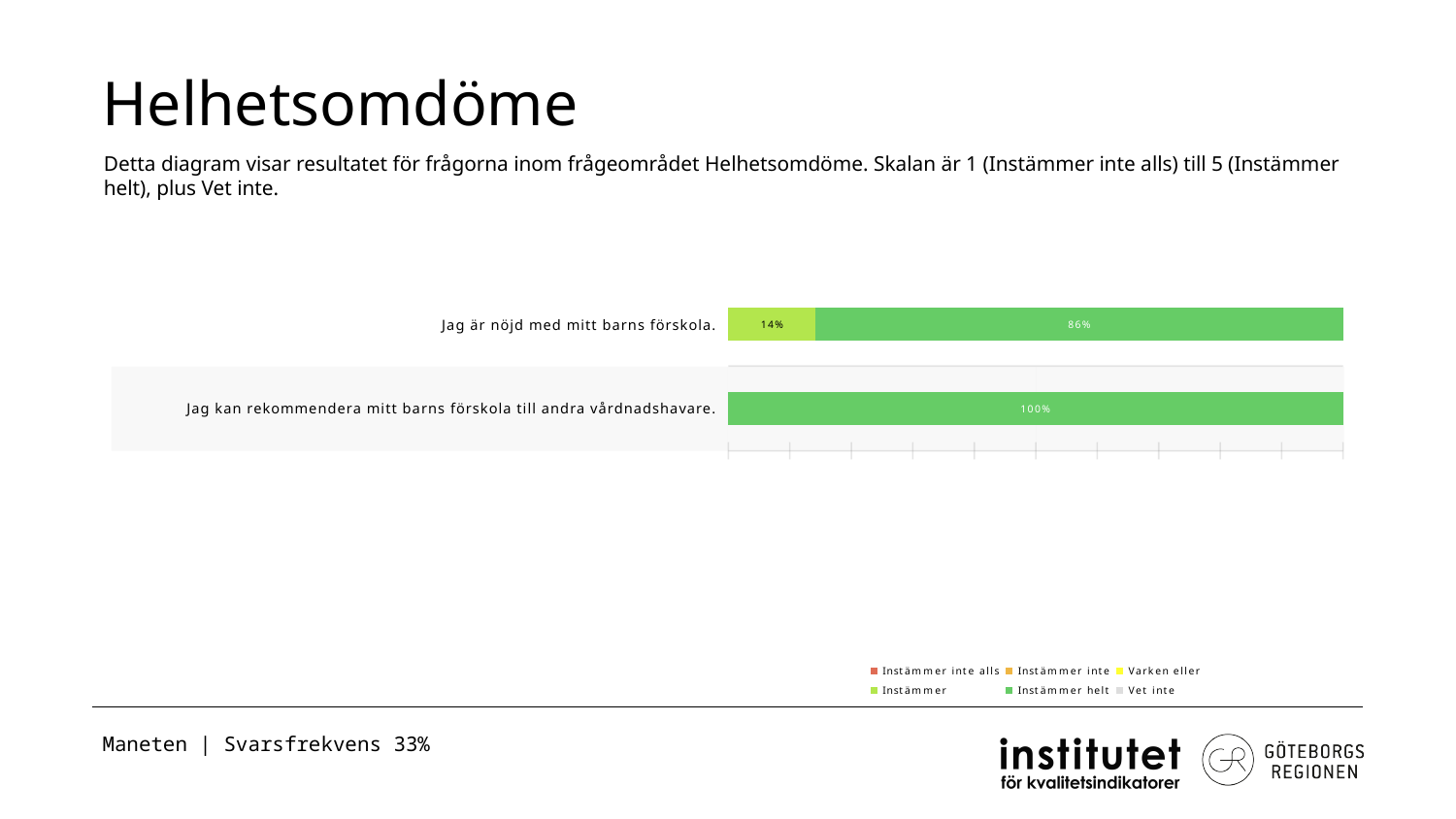
What kind of chart is shown on the slide? stacked bar chart What is the title of the slide containing the chart? Helhetsomdöme For 'Jag är nöjd med mitt barns förskola.', which is larger: the 'Instämmer' share or the 'Instämmer helt' share? Instämmer helt What is the 'Instämmer helt' value for 'Jag kan rekommendera mitt barns förskola till andra vårdnadshavare.'? 100% Which legend entry is shown in grey? Vet inte How many series does the legend list? 6 What is the 'Instämmer' value for 'Jag är nöjd med mitt barns förskola.'? 14% What is the difference between the 'Instämmer helt' values of the two statements? 14% What is the 'Instämmer helt' value for 'Jag är nöjd med mitt barns förskola.'? 86% How many categories (statements) are plotted in the chart? 2 Which statement has the higher 'Instämmer helt' share? Jag kan rekommendera mitt barns förskola till andra vårdnadshavare. What is the total of the stacked bar for 'Jag är nöjd med mitt barns förskola.'? 100%